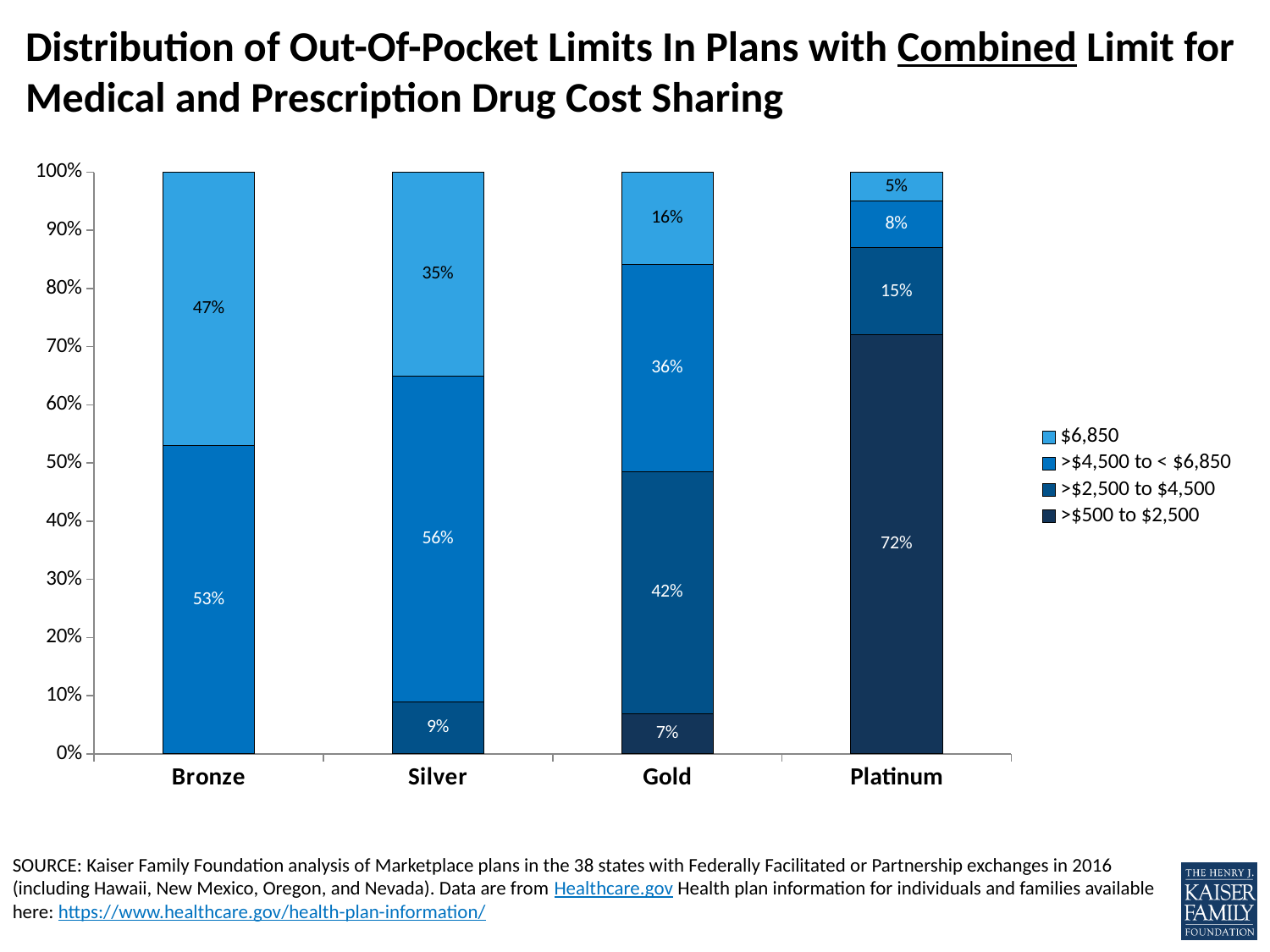
Does the share of plans with a $6,850 limit rise or fall moving from Bronze to Platinum? Fall How many percentage points higher is the >$4,500 to < $6,850 share for Silver than for Bronze? 3 percentage points Which has a larger share of plans with a >$2,500 to $4,500 limit, Gold or Platinum? Gold How many plan types are shown on the x axis? 4 What type of chart is shown on the slide? Stacked bar chart Which plan type has the highest share of plans with a $6,850 out-of-pocket limit? Bronze How many out-of-pocket limit ranges does the legend list? 4 What percentage of Platinum plans have an out-of-pocket limit of >$500 to $2,500? 72% Which plan type has the lowest share of plans with a $6,850 out-of-pocket limit? Platinum What percentage of Gold plans have an out-of-pocket limit of >$4,500 to < $6,850? 36% What percentage of Bronze plans have an out-of-pocket limit of $6,850? 47% What percentage of Silver plans have an out-of-pocket limit of >$2,500 to $4,500? 9%